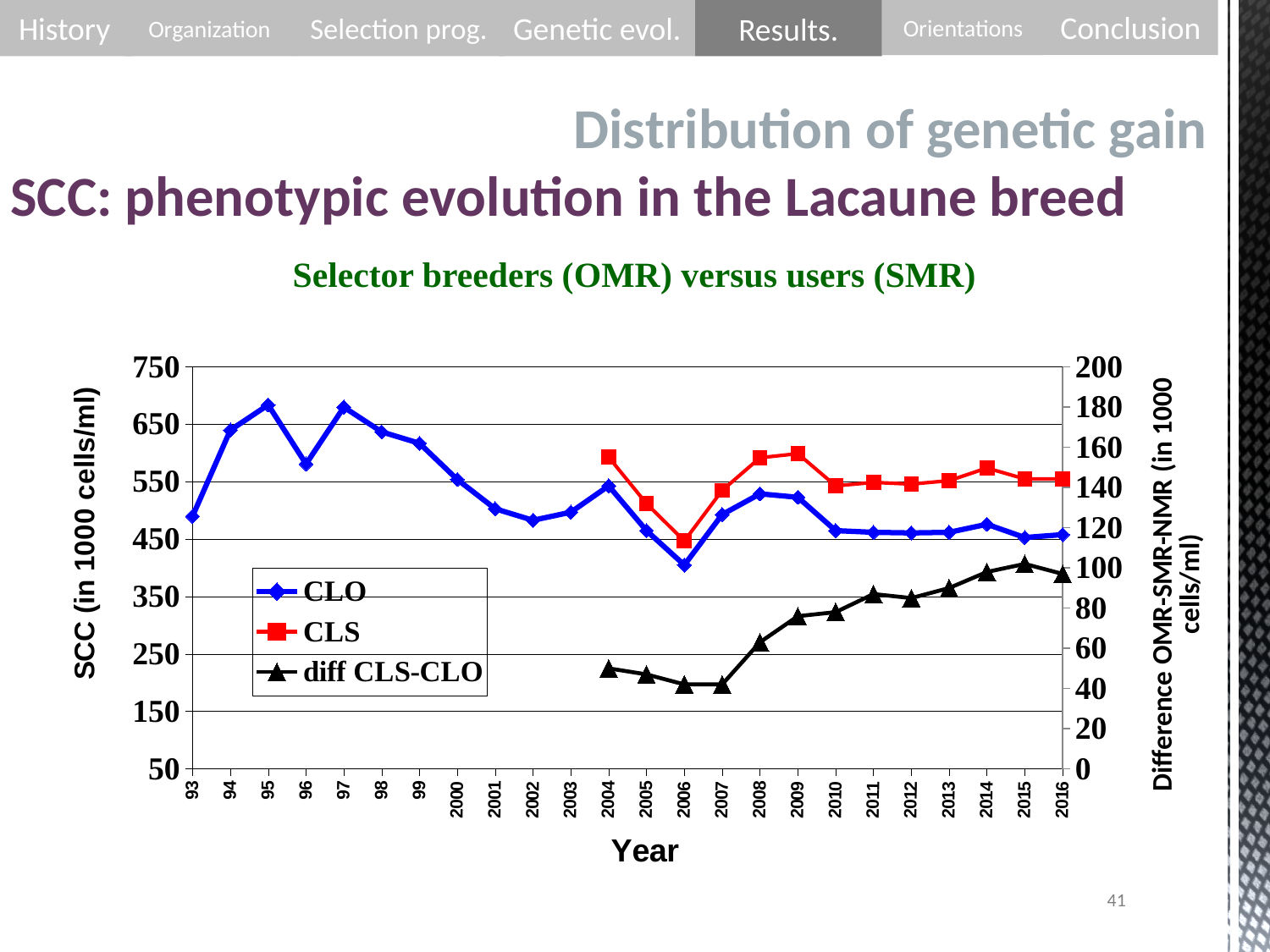
Does the diff CLS-CLO series rise or fall between 2007 and 2015? rise What are the three series named in the legend? CLO, CLS, diff CLS-CLO In which year is the CLO series at its lowest? 2006 What is the title of the left vertical axis? SCC (in 1000 cells/ml) Is the CLO value for 95 greater or less than 650? greater How many years are shown along the x axis of the chart? 24 In 2004, which is larger, the CLS value or the CLO value? CLS Is the CLS value for 2004 greater or less than 550? greater What kind of chart is shown on the slide? line chart How many series does the chart legend list? 3 Is the diff CLS-CLO value for 2007 greater or less than 60 on the right axis? less